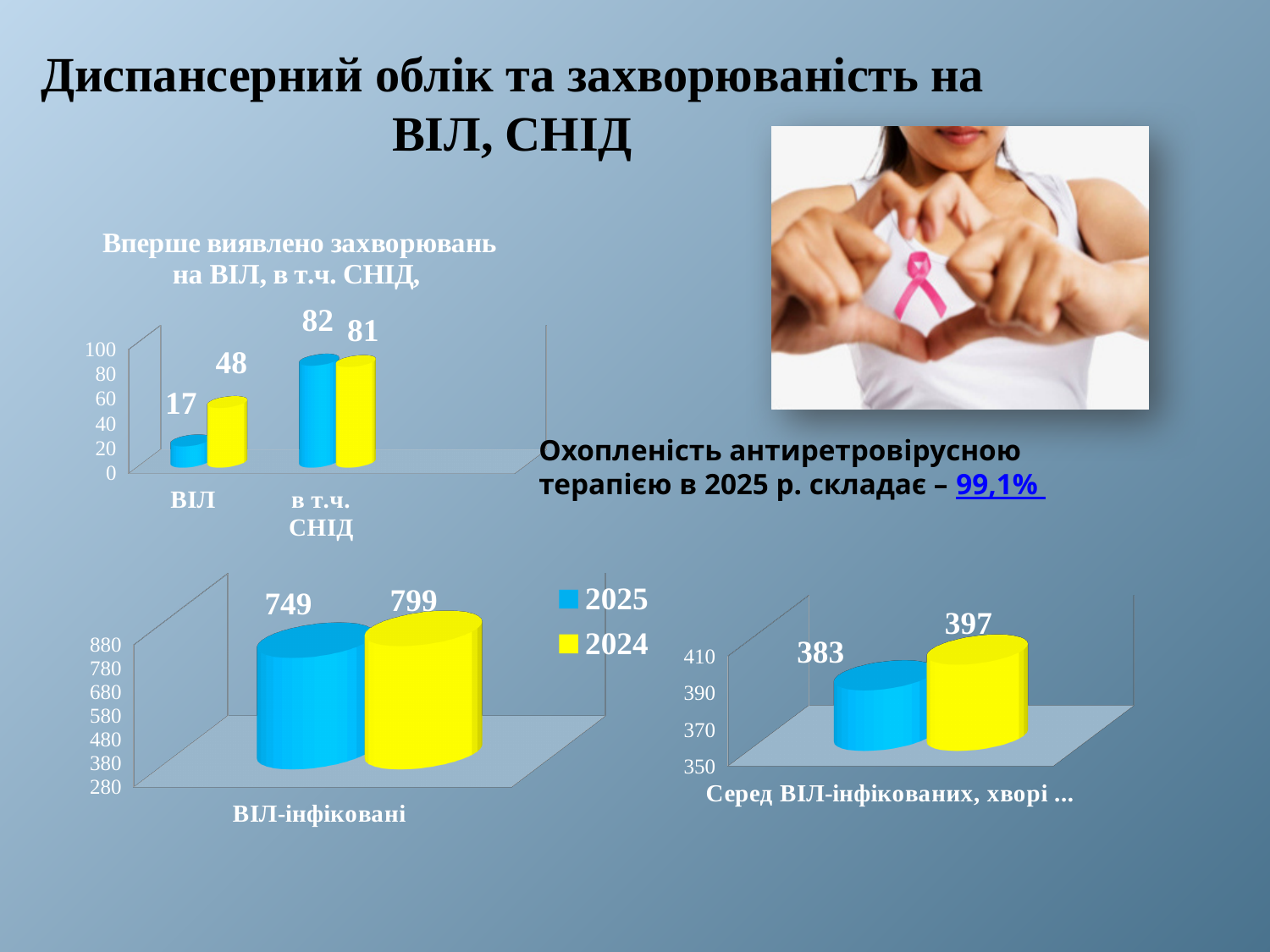
In the bottom-left chart 'ВІЛ-інфіковані', what is the difference between the 2024 and 2025 values? 50 In the top-left chart 'Вперше виявлено захворювань на ВІЛ, в т.ч. СНІД', what is the difference between the 2024 and 2025 values for ВІЛ? 31 In the top-left chart 'Вперше виявлено захворювань на ВІЛ, в т.ч. СНІД', what is the value of the blue (2025) bar for ВІЛ? 17 In the bottom-right chart 'Серед ВІЛ-інфікованих, хворі ...', what is the value of the blue (2025) bar? 383 In the top-left chart 'Вперше виявлено захворювань на ВІЛ, в т.ч. СНІД', how many categories are shown on the x axis? 2 In the bottom-left chart 'ВІЛ-інфіковані', what is the value of the yellow (2024) bar? 799 In the top-left chart 'Вперше виявлено захворювань на ВІЛ, в т.ч. СНІД', what is the value of the yellow (2024) bar for ВІЛ? 48 In the top-left chart 'Вперше виявлено захворювань на ВІЛ, в т.ч. СНІД', what is the value of the blue (2025) bar for в т.ч. СНІД? 82 What type of chart is the bottom-left chart 'ВІЛ-інфіковані'? Bar chart In the bottom-right chart 'Серед ВІЛ-інфікованих, хворі ...', which year has the larger value, 2024 or 2025? 2024 How many series does the legend on the slide list? 2 In the bottom-left chart 'ВІЛ-інфіковані', what is the value of the blue (2025) bar? 749